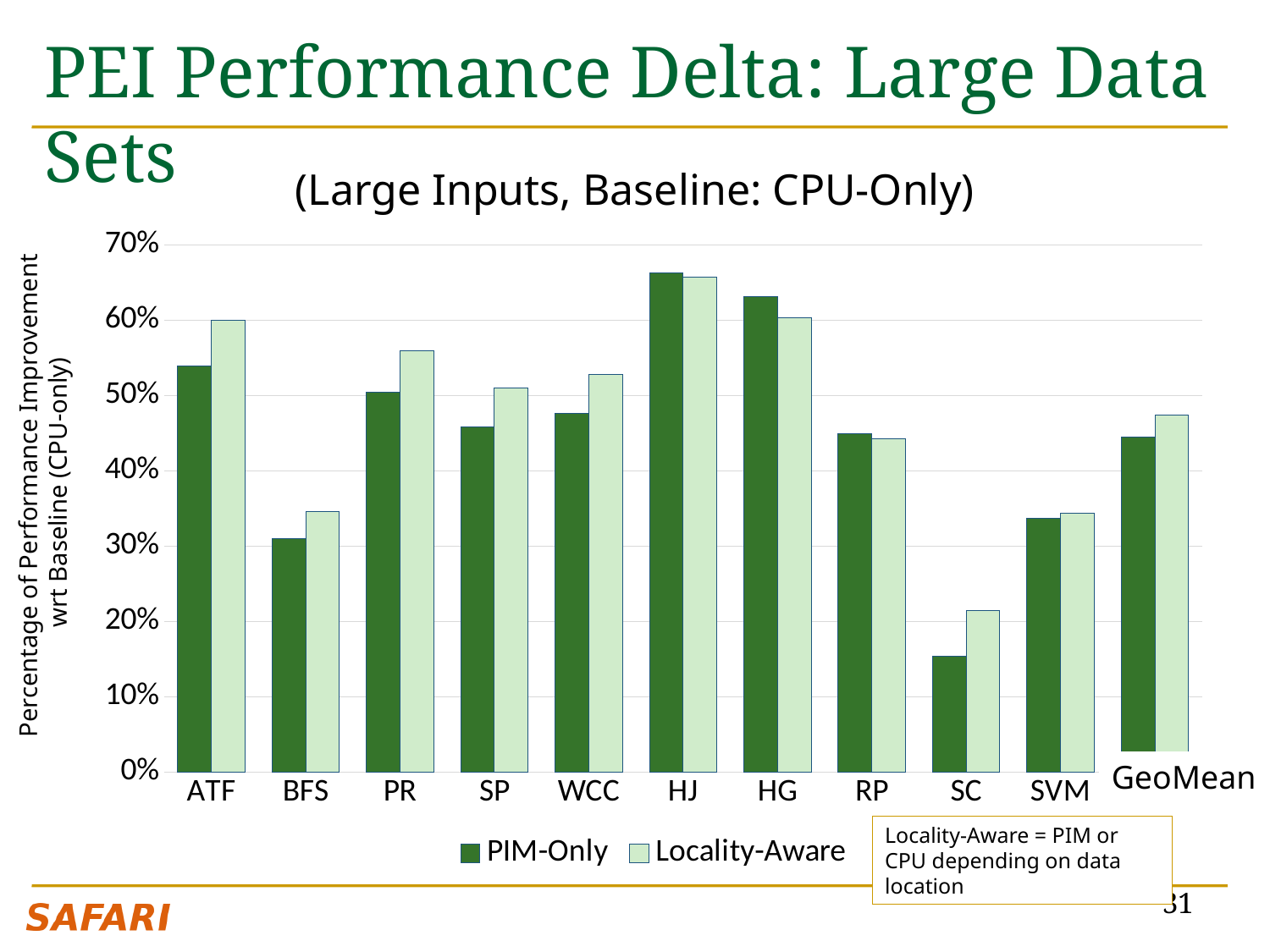
For HG, which is larger: the PIM-Only value or the Locality-Aware value? PIM-Only Which category has the lowest Locality-Aware value? SC How many series does the legend list? 2 Which category has the lowest PIM-Only value? SC Is the PIM-Only value for SC greater or less than 20%? less Is the PIM-Only value for HJ greater or less than 60%? greater Is the Locality-Aware value for SC greater or less than 20%? greater Which category has the highest PIM-Only value? HJ For ATF, which is larger: the PIM-Only value or the Locality-Aware value? Locality-Aware How many categories are shown on the x axis? 11 What kind of chart is shown on the slide? bar chart